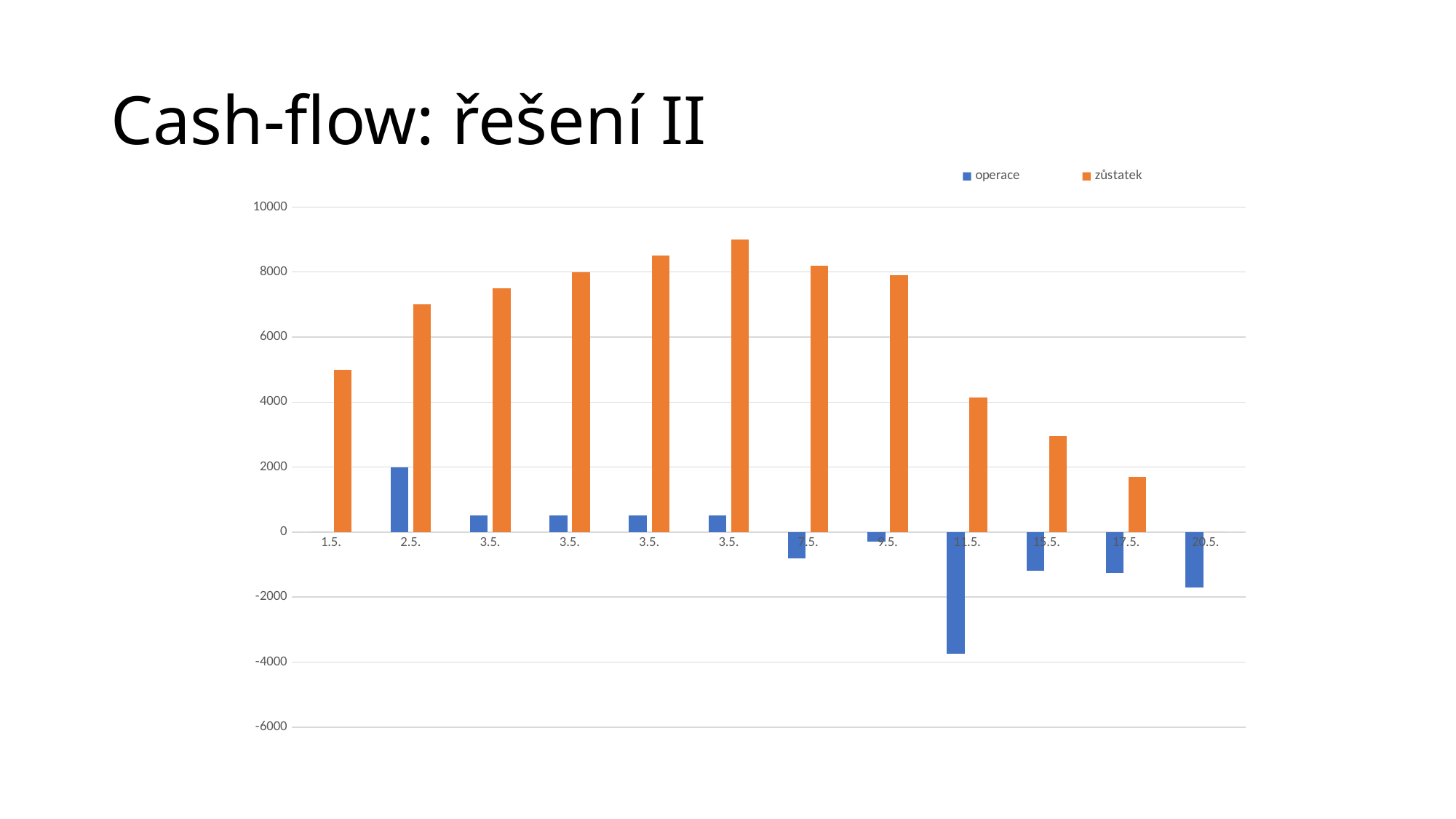
What are the two series named in the legend? operace and zůstatek Which is larger, the zůstatek value for 1.5. or for 2.5.? 2.5. Which date has the lowest operace value? 11.5. Is the operace value for 11.5. greater or less than -2000? less Which date has the lowest zůstatek value? 20.5. What colour are the zůstatek bars? orange What kind of chart is shown on the slide? bar chart Is the zůstatek value for 17.5. greater or less than 2000? less Which date has the highest operace value? 2.5. Is the zůstatek value for 1.5. greater or less than 4000? greater How many date categories are shown on the x axis? 12 How many series does the legend list? 2